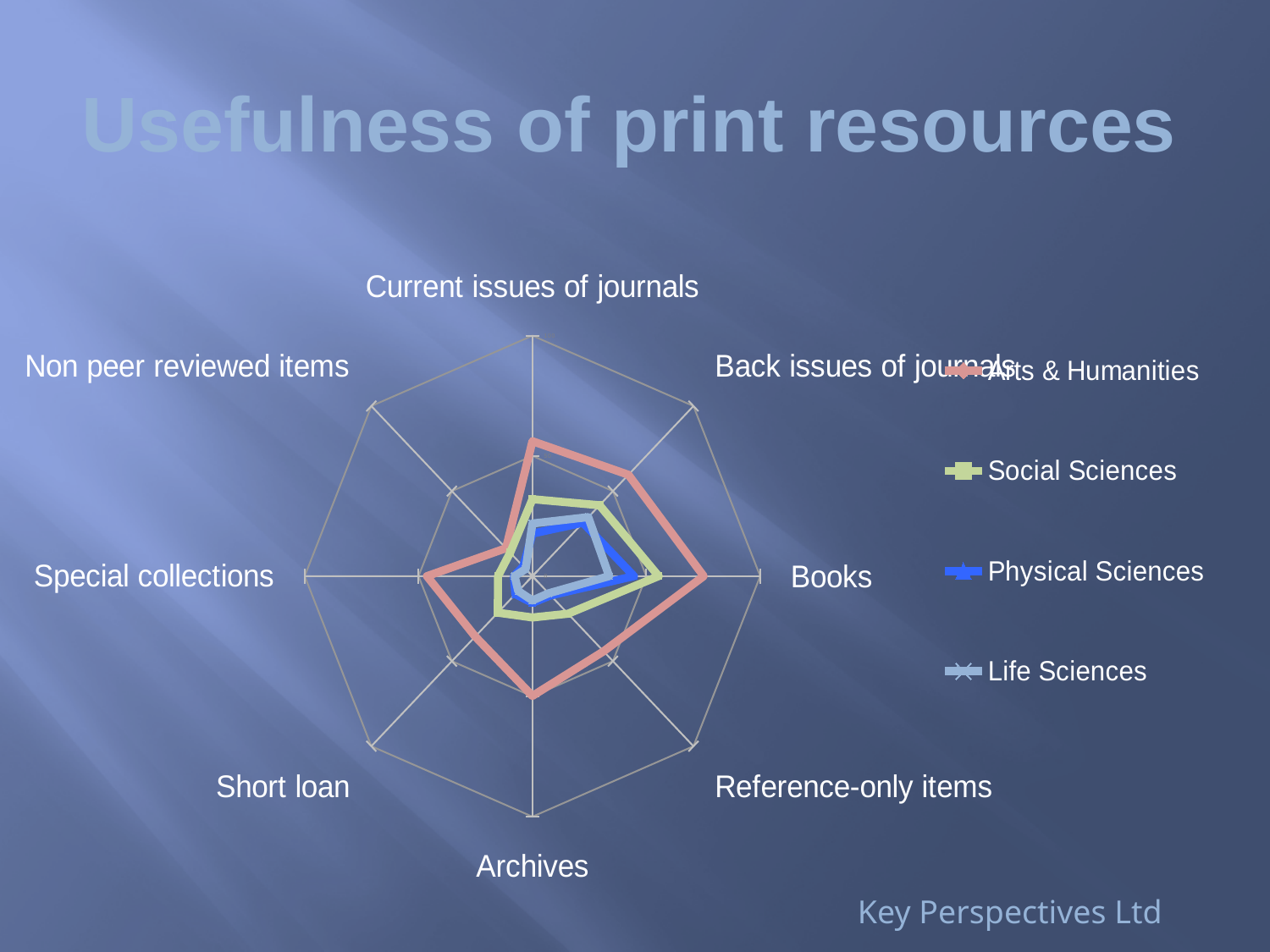
For which category does the Arts & Humanities series have its lowest value? Non peer reviewed items For Back issues of journals, which is larger: Arts & Humanities or Social Sciences? Arts & Humanities How many series does the legend list? 4 For Short loan, which is larger: Arts & Humanities or Life Sciences? Arts & Humanities What is the title of the slide chart? Usefulness of print resources For Books, which is larger: Arts & Humanities or Physical Sciences? Arts & Humanities How many categories (axes) does the radar chart have? 8 Which series has the highest value for Archives? Arts & Humanities For which category does the Arts & Humanities series reach its highest value? Books What kind of chart is shown on the slide? Radar chart Which series is shown in red/pink in the legend? Arts & Humanities Which series has the highest value for Books? Arts & Humanities